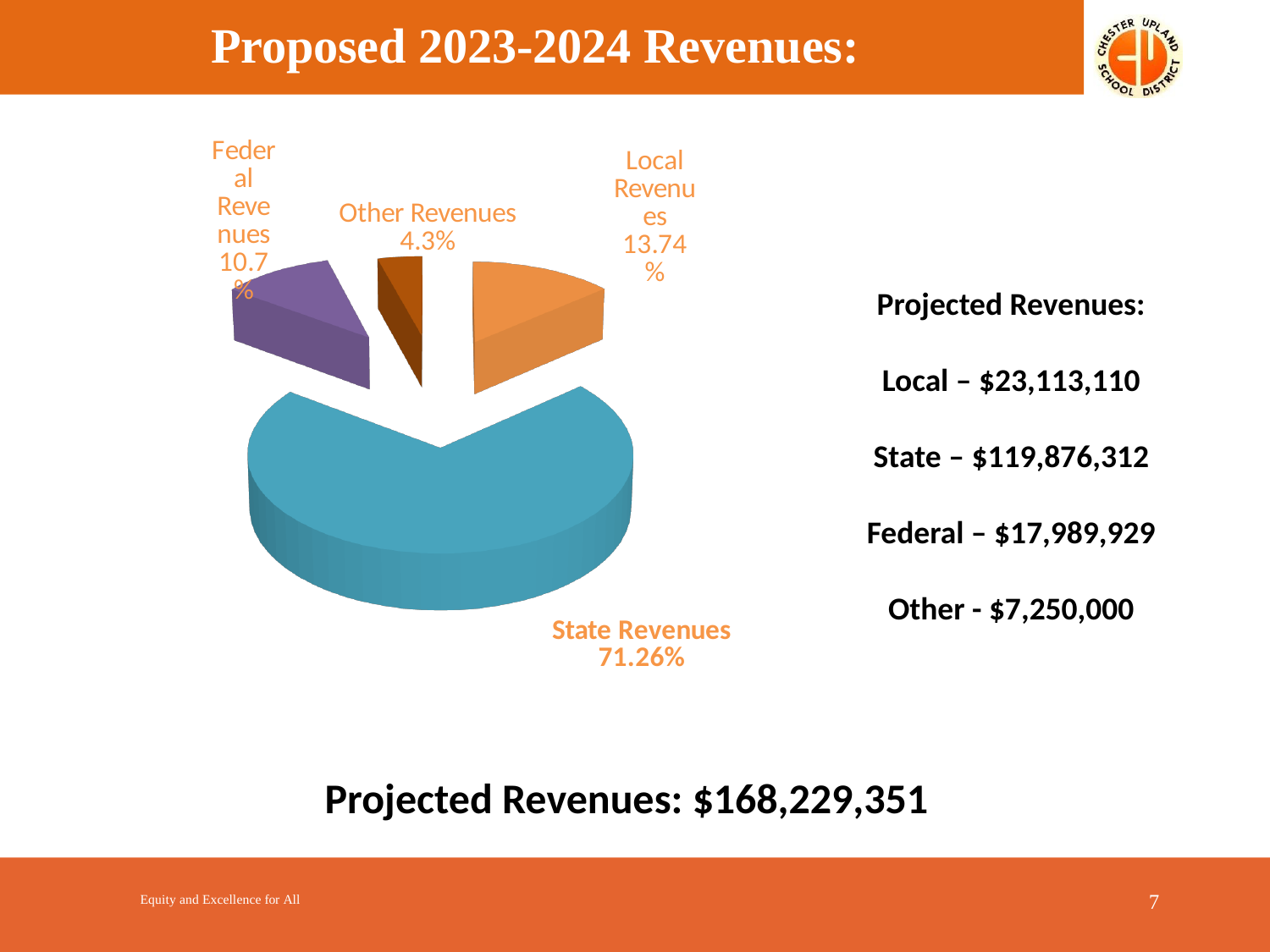
What share of the pie is Local Revenues? 13.74% Which slice of the pie chart is the smallest? Other Revenues What is the difference in percentage points between Federal Revenues and Other Revenues? 6.4 Which is larger in the pie chart, Local Revenues or Federal Revenues? Local Revenues How many slices does the pie chart have? 4 What kind of chart is shown on the slide? pie chart What share of the pie is State Revenues? 71.26% What colour is the State Revenues slice of the pie chart? teal blue What is the difference in percentage points between State Revenues and Local Revenues? 57.52 Which slice of the pie chart is the largest? State Revenues What share of the pie is Other Revenues? 4.3%